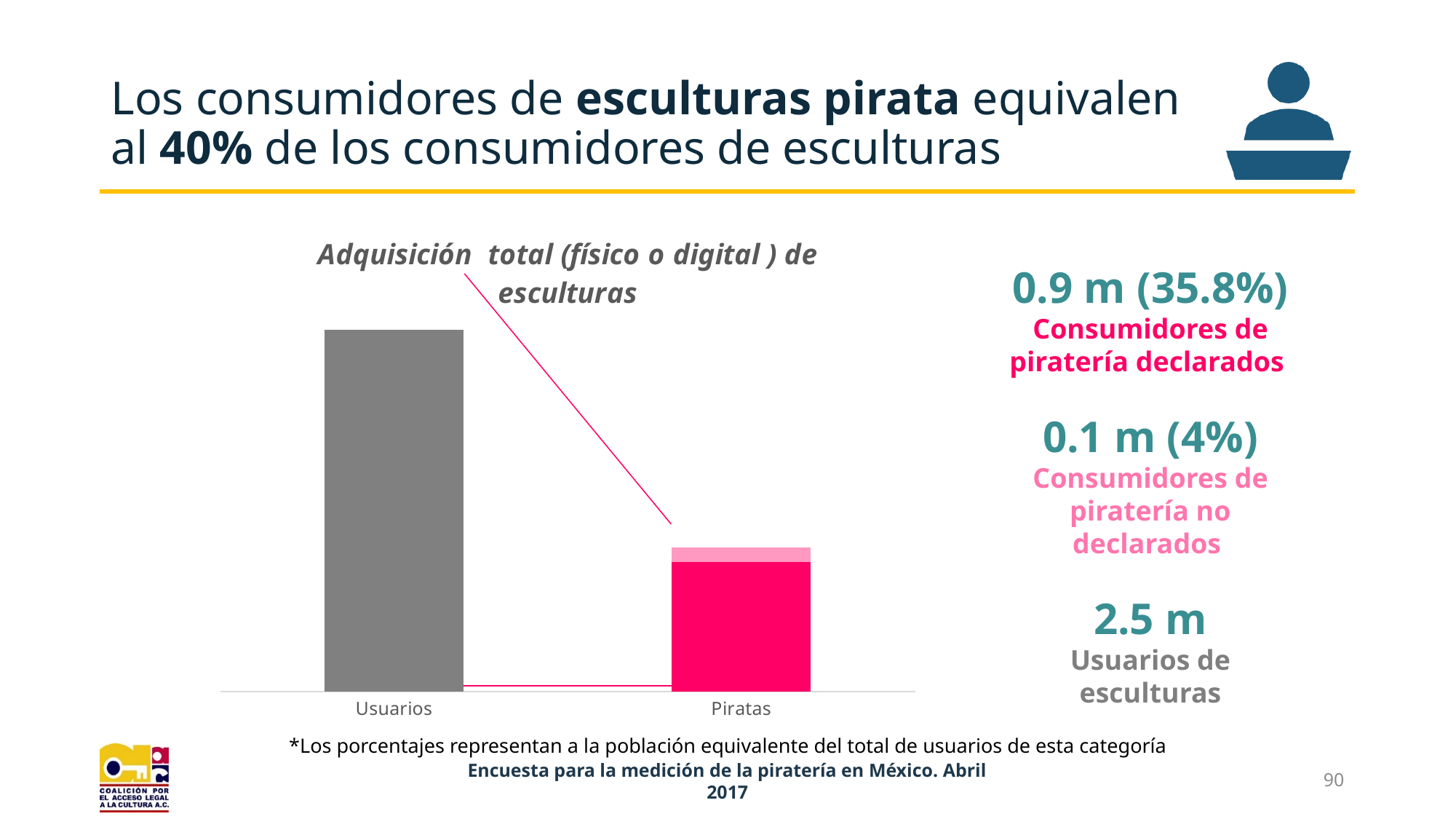
According to the slide, what is the value for declared piracy consumers (Consumidores de piratería declarados)? 0.9 m (35.8%) Which category has the taller bar, Usuarios or Piratas? Usuarios What are the two category labels on the x axis of the chart? Usuarios and Piratas Do the bar values fall or rise from Usuarios to Piratas along the x axis? fall According to the slide, how many users of sculptures (Usuarios de esculturas) are there? 2.5 m What is the total of the stacked Piratas bar, combining declared (0.9 m) and non-declared (0.1 m) piracy consumers? 1.0 m According to the slide, what is the value for non-declared piracy consumers (Consumidores de piratería no declarados)? 0.1 m (4%) What is the title of the chart? Adquisición total (físico o digital ) de esculturas How many categories are shown on the x axis of the chart? 2 Which category has the highest bar in the chart? Usuarios What kind of chart is shown on the slide? bar chart Which category has the lowest bar in the chart? Piratas